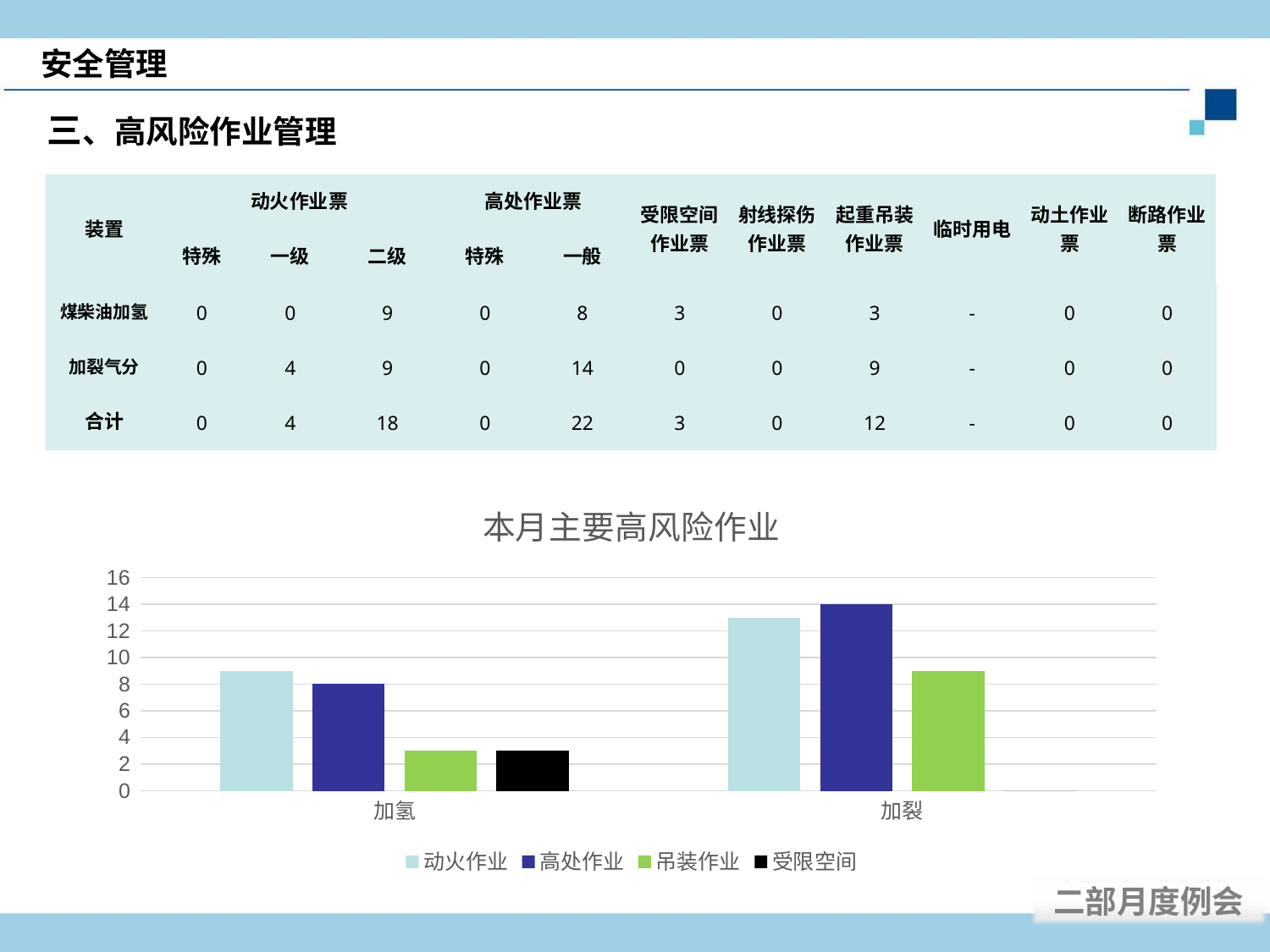
What is the title of the chart on the slide? 本月主要高风险作业 In the 本月主要高风险作业 chart, what colour represents 受限空间 in the legend? black What kind of chart is shown under the title 本月主要高风险作业? bar chart In the 本月主要高风险作业 chart, what is the value of 高处作业 for 加氢? 8 In the 本月主要高风险作业 chart, is the value of 吊装作业 for 加氢 greater or less than 4? less In the 本月主要高风险作业 chart, does the 动火作业 value rise or fall from 加氢 to 加裂? rise In the 本月主要高风险作业 chart, which series has the highest value for 加裂? 高处作业 In the 本月主要高风险作业 chart, what is the value of 高处作业 for 加裂? 14 How many series does the legend of the 本月主要高风险作业 chart list? 4 In the 本月主要高风险作业 chart, is the value of 动火作业 for 加裂 greater or less than 12? greater In the 本月主要高风险作业 chart, which category has the larger 吊装作业 value, 加氢 or 加裂? 加裂 How many categories are shown on the x axis of the 本月主要高风险作业 chart? 2